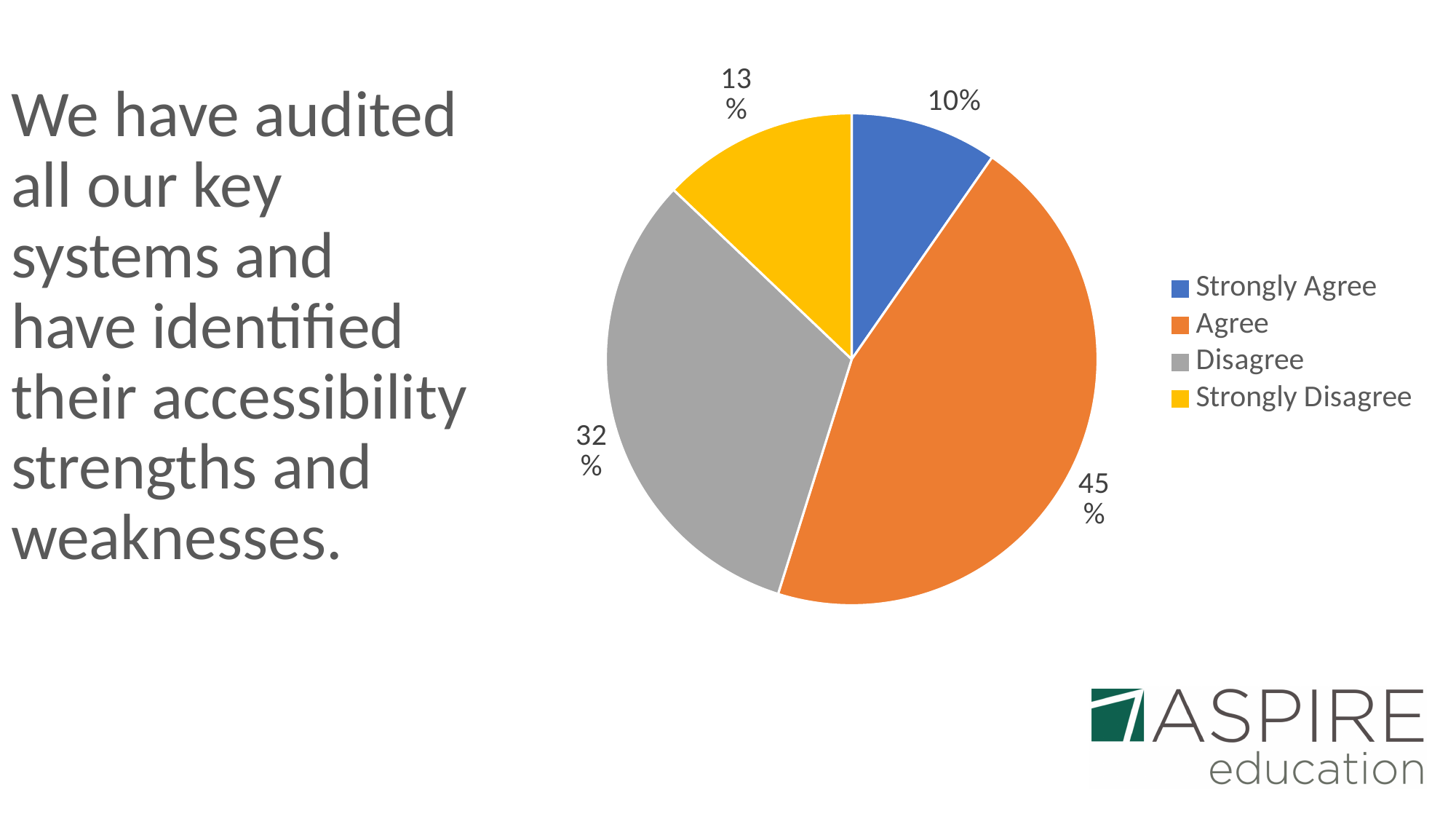
What percentage of respondents chose Disagree? 32% What colour is the Disagree slice? Grey What percentage of respondents chose Strongly Agree? 10% What kind of chart is shown on the slide? Pie chart What is the difference in percentage points between Agree and Disagree? 13 Which is larger, the share for Disagree or the share for Strongly Disagree? Disagree What percentage of respondents chose Agree? 45% Which response has the largest share of the pie? Agree What percentage of respondents chose Strongly Disagree? 13% What is the combined share of Strongly Agree and Agree? 55% How many categories does the pie chart show? 4 Which response has the smallest share of the pie? Strongly Agree